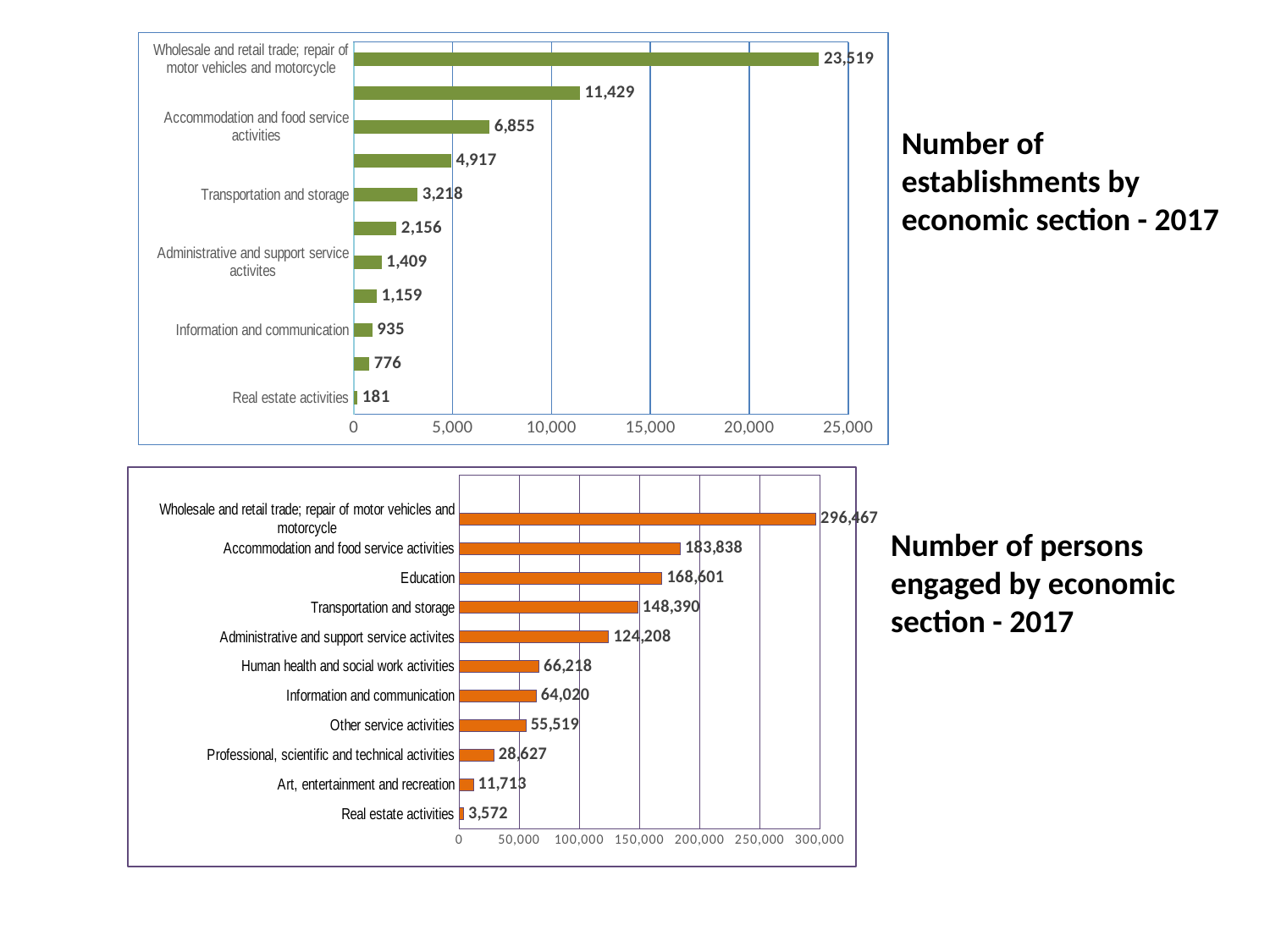
In the 'Number of persons engaged by economic section - 2017' chart, is the value for Administrative and support service activites greater or less than 100,000? greater In the 'Number of persons engaged by economic section - 2017' chart, what is the value for Art, entertainment and recreation? 11,713 In the 'Number of persons engaged by economic section - 2017' chart, how many categories are shown? 11 In the 'Number of establishments by economic section - 2017' chart, what is the difference between Accommodation and food service activities and Information and communication? 5,920 In the 'Number of establishments by economic section - 2017' chart, how many bars are plotted? 11 What type of chart is the 'Number of persons engaged by economic section - 2017' chart? Bar chart In the 'Number of establishments by economic section - 2017' chart, what is the value for Wholesale and retail trade; repair of motor vehicles and motorcycle? 23,519 In the 'Number of establishments by economic section - 2017' chart, which category has the lowest value? Real estate activities In the 'Number of persons engaged by economic section - 2017' chart, which category has the highest value? Wholesale and retail trade; repair of motor vehicles and motorcycle In the 'Number of persons engaged by economic section - 2017' chart, which is larger: Human health and social work activities or Other service activities? Human health and social work activities In the 'Number of establishments by economic section - 2017' chart, what is the value for Transportation and storage? 3,218 In the 'Number of persons engaged by economic section - 2017' chart, what is the value for Education? 168,601